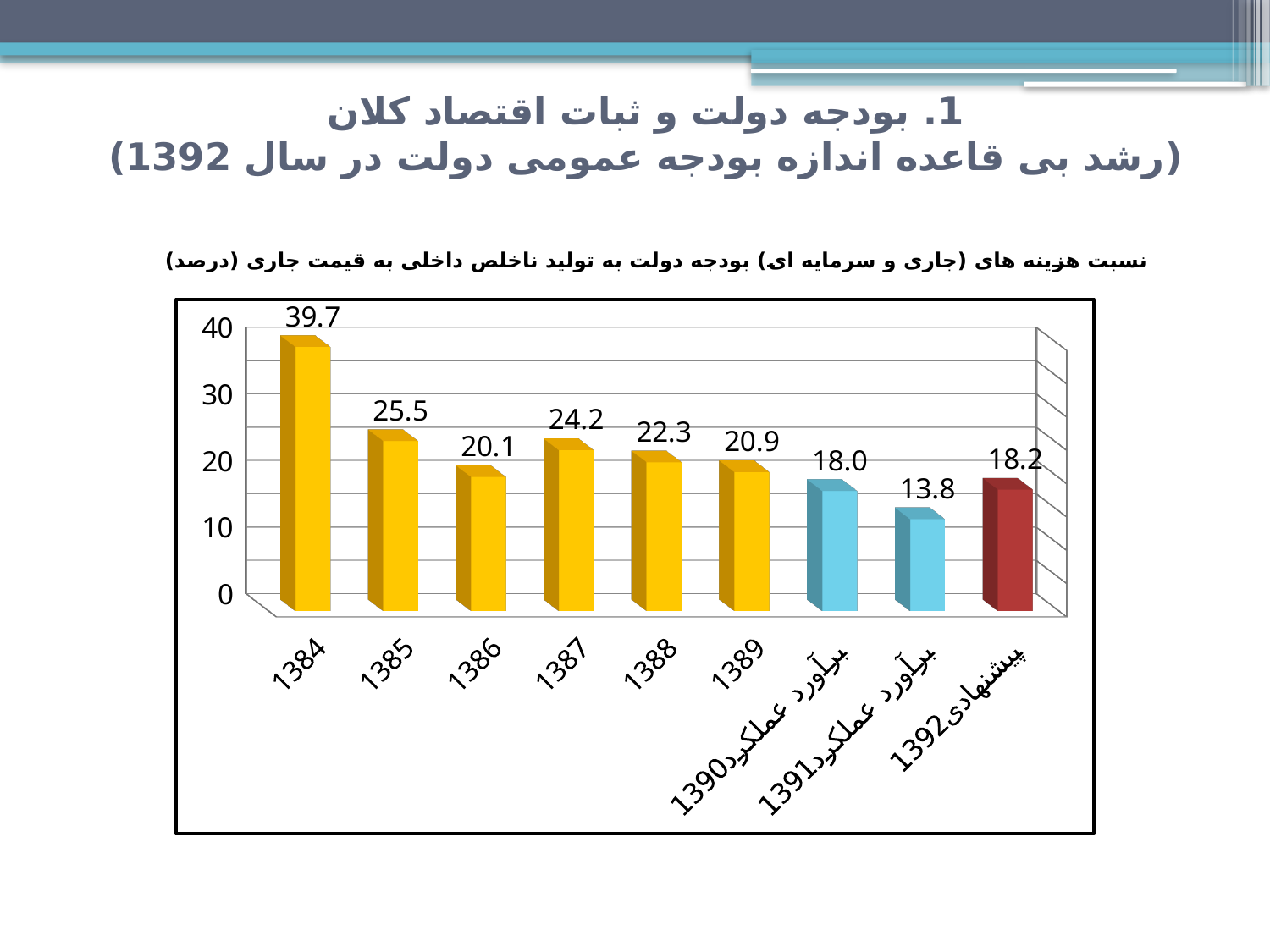
What kind of chart is shown on the slide? bar chart Which category has the highest value? 1384 Which category has the lowest value? برآورد عملکرد 1391 What is the value for 1387? 24.2 Which is larger, the value for 1386 or the value for 1389? 1389 What is the value for پیشنهادی 1392? 18.2 What is the value for 1384? 39.7 How many categories are shown on the x axis? 9 Is the value for 1388 greater or less than 20? greater What is the difference between the values for 1384 and 1385? 14.2 What is the value for برآورد عملکرد 1391? 13.8 What colour is the bar for پیشنهادی 1392? dark red